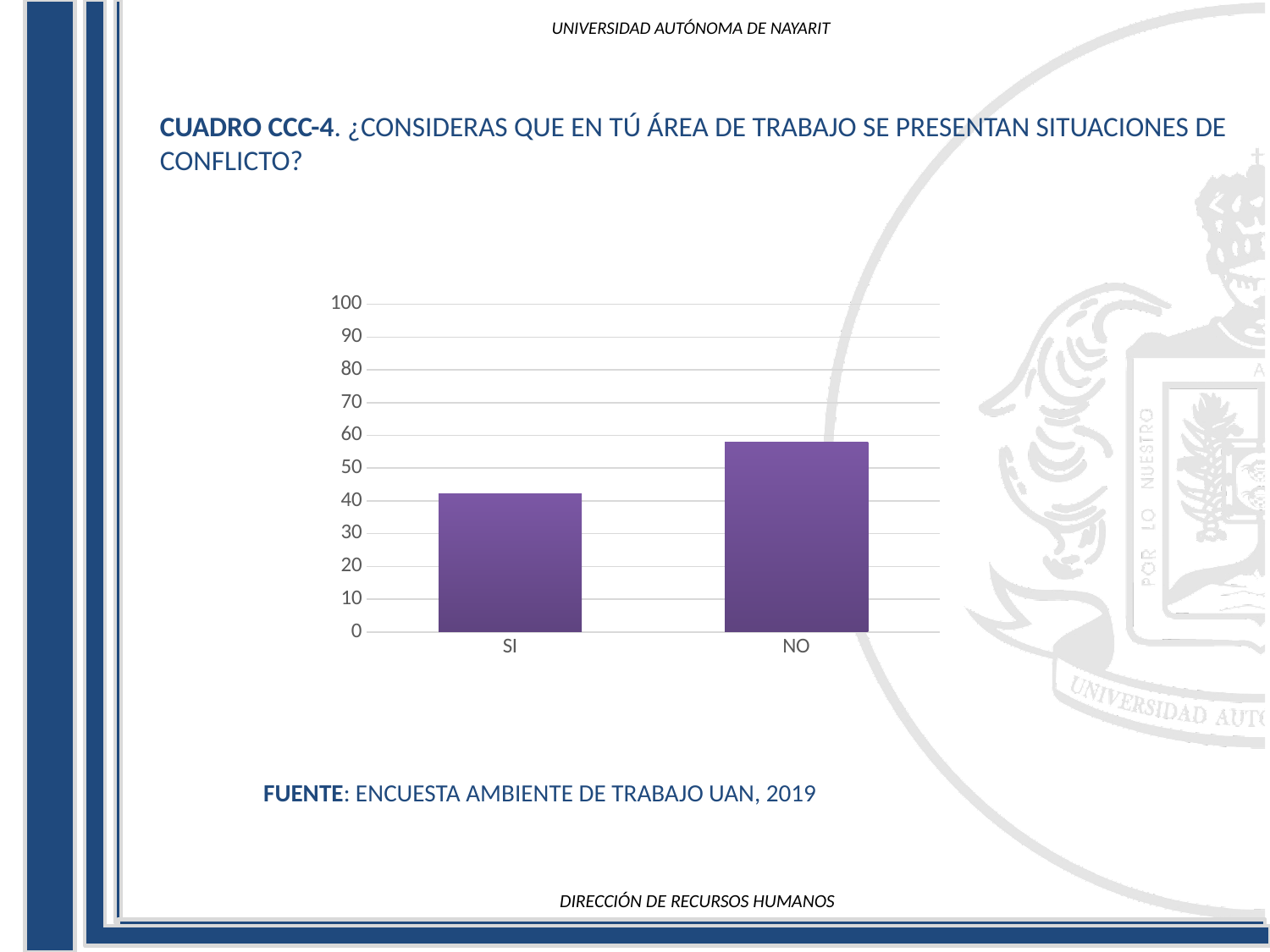
Is the value for NO greater or less than 50? greater Is the value for NO greater or less than 70? less What kind of chart is shown on the slide? bar chart Which is larger, the value for SI or the value for NO? NO Which category has the highest bar in the chart? NO How many categories are shown on the x axis of the chart? 2 What is the source cited below the chart? ENCUESTA AMBIENTE DE TRABAJO UAN, 2019 Which category has the lowest bar in the chart? SI What is the highest value shown on the y axis of the chart? 100 Is the value for SI greater or less than 50? less